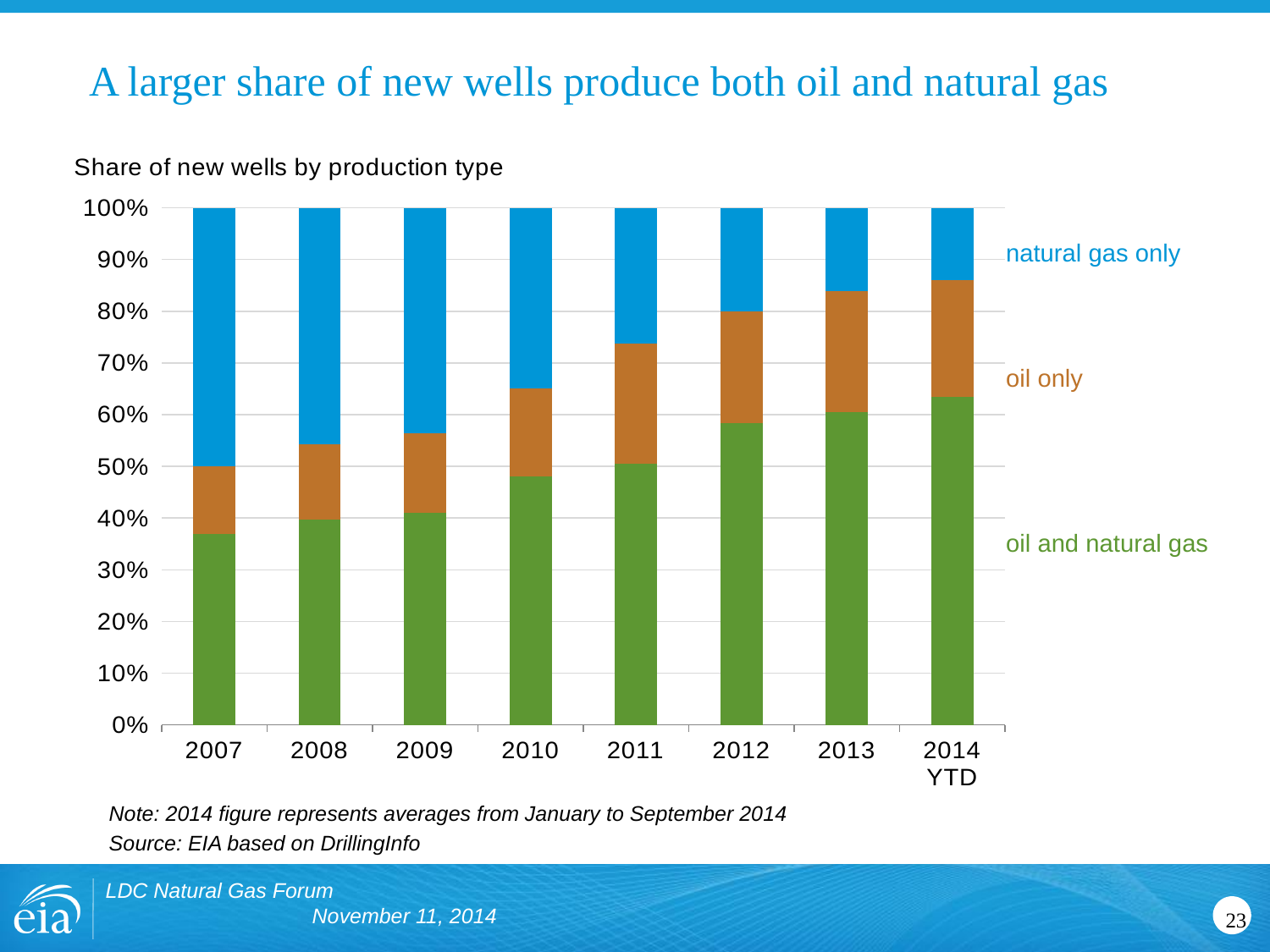
How many years (categories) are shown on the x axis? 8 Is the share of oil and natural gas wells in 2014 YTD greater or less than 60%? greater How many production-type series are plotted in the chart? 3 Does the share of natural gas only wells rise or fall from 2007 to 2014 YTD? Fall Does the share of new wells producing oil and natural gas rise or fall from 2007 to 2014 YTD? Rise In which year is the share of oil and natural gas wells lowest? 2007 Which is larger, the share of oil and natural gas wells in 2012 or in 2009? 2012 In which year is the share of oil and natural gas wells highest? 2014 YTD In which year is the share of natural gas only wells highest? 2007 Is the share of oil and natural gas wells in 2007 greater or less than 40%? less What kind of chart is shown on the slide? Stacked bar chart What is the title of the chart? Share of new wells by production type